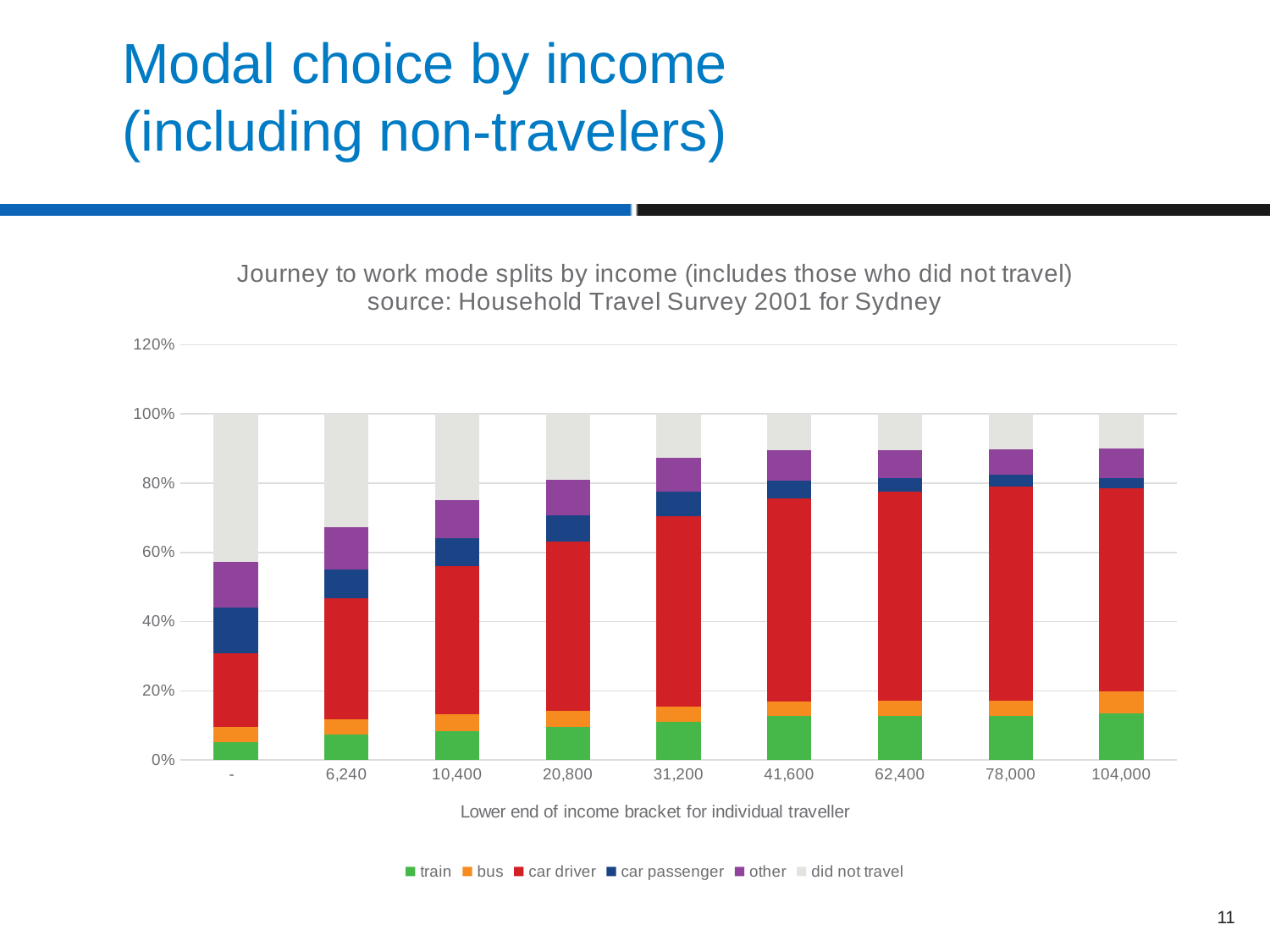
Which income bracket has the largest 'did not travel' share? - Which series is shown in red in the chart? car driver What is the total height of the stacked bar for the 104,000 income bracket? 100% Which income bracket has the smallest 'train' share? - Does the 'did not travel' share rise or fall as income increases along the x axis? fall How many series does the legend list? 6 Is the 'did not travel' share for the '-' income bracket greater or less than 40%? greater Is the 'train' share for the 104,000 income bracket greater or less than 20%? less Which has a larger 'car driver' share: the '-' bracket or the 78,000 bracket? 78,000 How many income brackets are shown along the x axis? 9 What is the x-axis label of the chart? Lower end of income bracket for individual traveller What kind of chart is shown on the slide? stacked bar chart